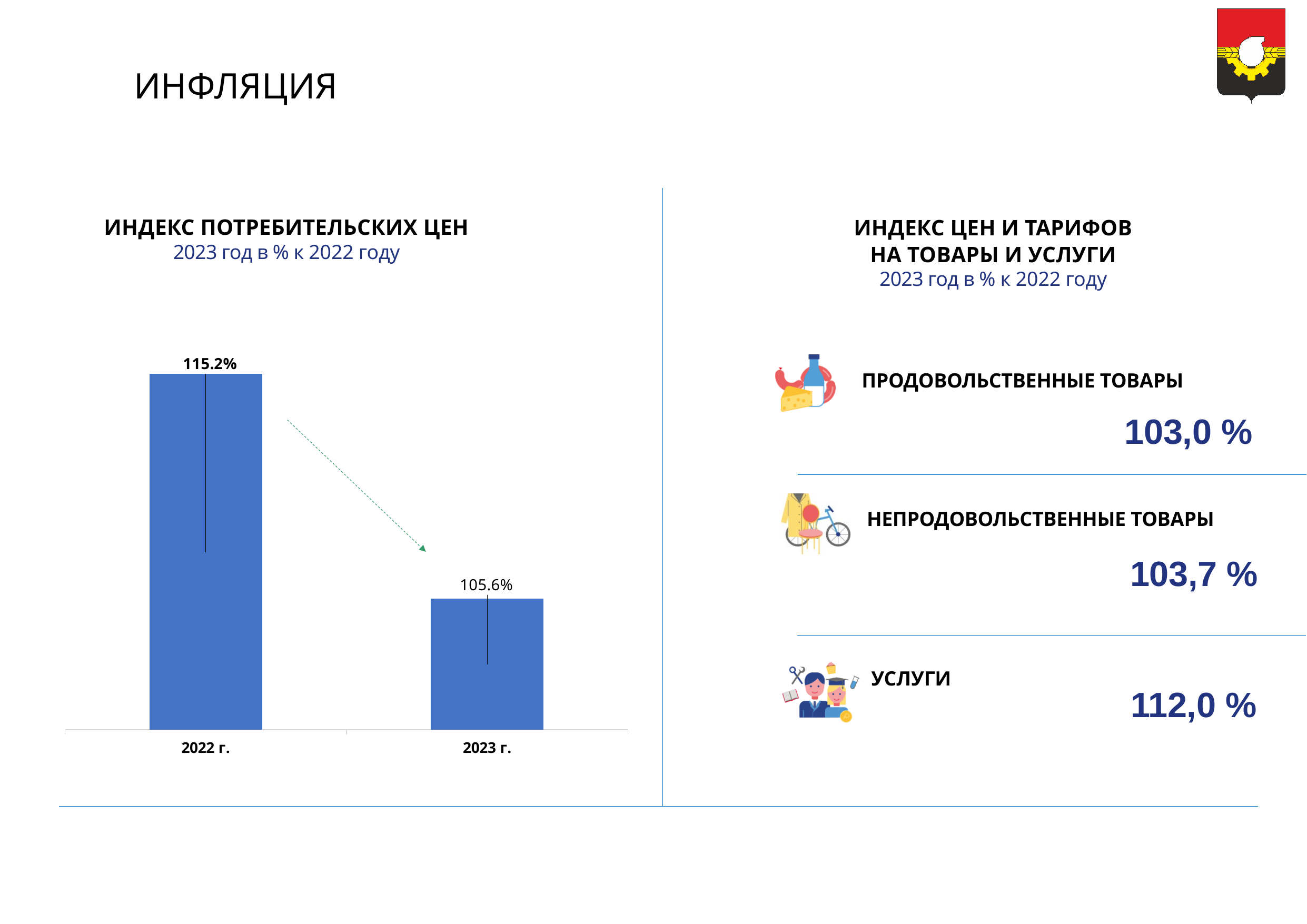
Which year has the highest value in the ИНДЕКС ПОТРЕБИТЕЛЬСКИХ ЦЕН chart? 2022 г. What is the value for 2022 г. in the ИНДЕКС ПОТРЕБИТЕЛЬСКИХ ЦЕН chart? 115.2% What is the value for 2023 г. in the ИНДЕКС ПОТРЕБИТЕЛЬСКИХ ЦЕН chart? 105.6% Do the values in the ИНДЕКС ПОТРЕБИТЕЛЬСКИХ ЦЕН chart rise or fall from 2022 г. to 2023 г.? Fall By how many percentage points does the 2022 г. value exceed the 2023 г. value in the ИНДЕКС ПОТРЕБИТЕЛЬСКИХ ЦЕН chart? 9.6 Which year has the lowest value in the ИНДЕКС ПОТРЕБИТЕЛЬСКИХ ЦЕН chart? 2023 г. How many bars are shown in the ИНДЕКС ПОТРЕБИТЕЛЬСКИХ ЦЕН chart? 2 In the ИНДЕКС ПОТРЕБИТЕЛЬСКИХ ЦЕН chart, is the value for 2022 г. or 2023 г. larger? 2022 г. What kind of chart is the ИНДЕКС ПОТРЕБИТЕЛЬСКИХ ЦЕН chart? Bar chart What colour are the bars in the ИНДЕКС ПОТРЕБИТЕЛЬСКИХ ЦЕН chart? Blue What is the subtitle shown under the title of the ИНДЕКС ПОТРЕБИТЕЛЬСКИХ ЦЕН chart? 2023 год в % к 2022 году